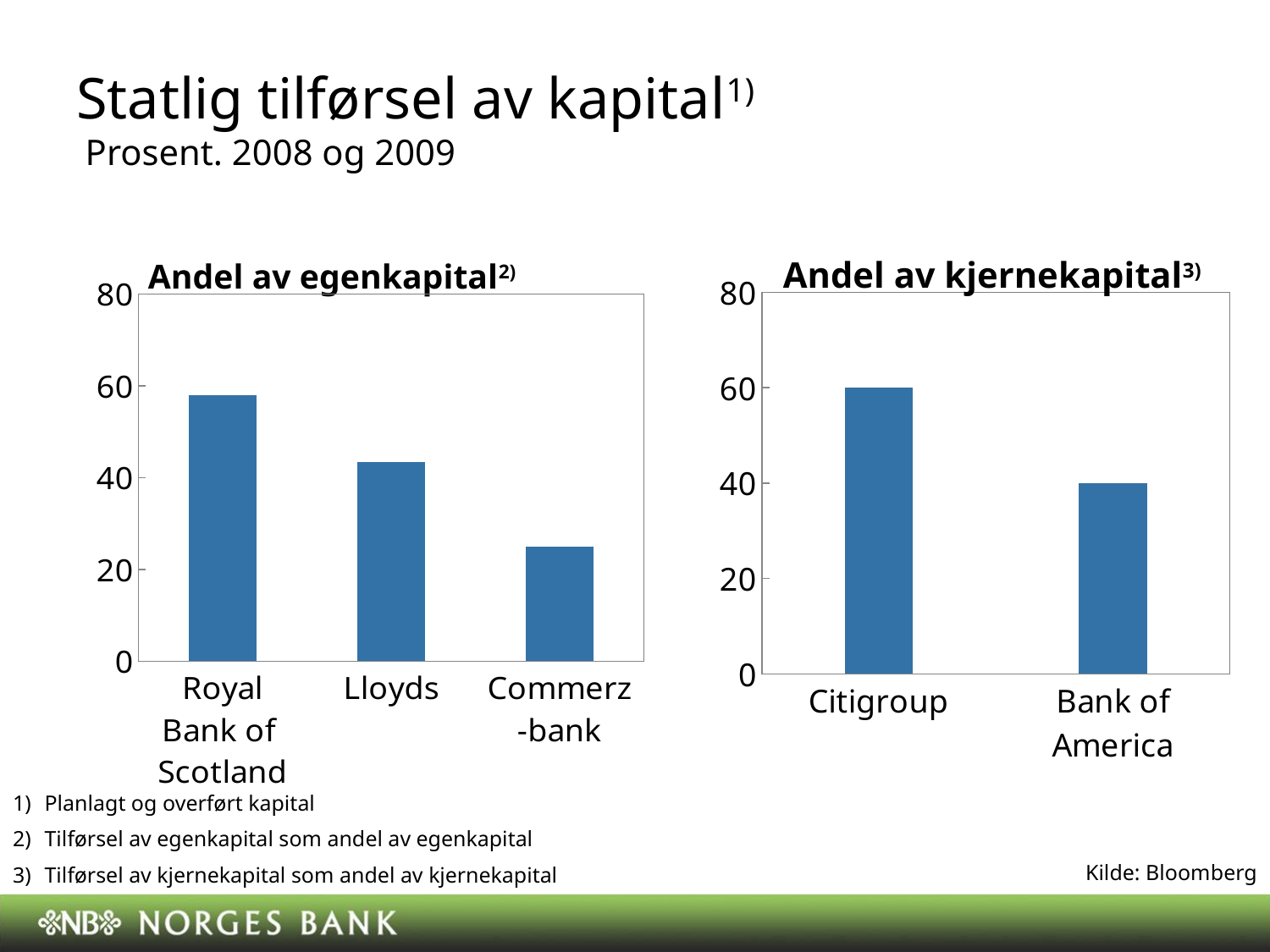
What is the source cited on the slide? Bloomberg In the 'Andel av egenkapital' chart, which bank has the lowest value? Commerzbank In the 'Andel av kjernekapital' chart, which bank has the higher value, Citigroup or Bank of America? Citigroup In the 'Andel av kjernekapital' chart, what is the value for Bank of America? 40 In the 'Andel av kjernekapital' chart, what is the difference between the values for Citigroup and Bank of America? 20 In the 'Andel av egenkapital' chart, is the value for Lloyds greater or less than 40? greater In the 'Andel av egenkapital' chart, how many banks are shown? 3 In the 'Andel av egenkapital' chart, which bank has the highest value? Royal Bank of Scotland What kind of chart is the 'Andel av kjernekapital' chart? Bar chart In the 'Andel av kjernekapital' chart, what is the value for Citigroup? 60 In the 'Andel av egenkapital' chart, is the value for Commerzbank greater or less than 40? less